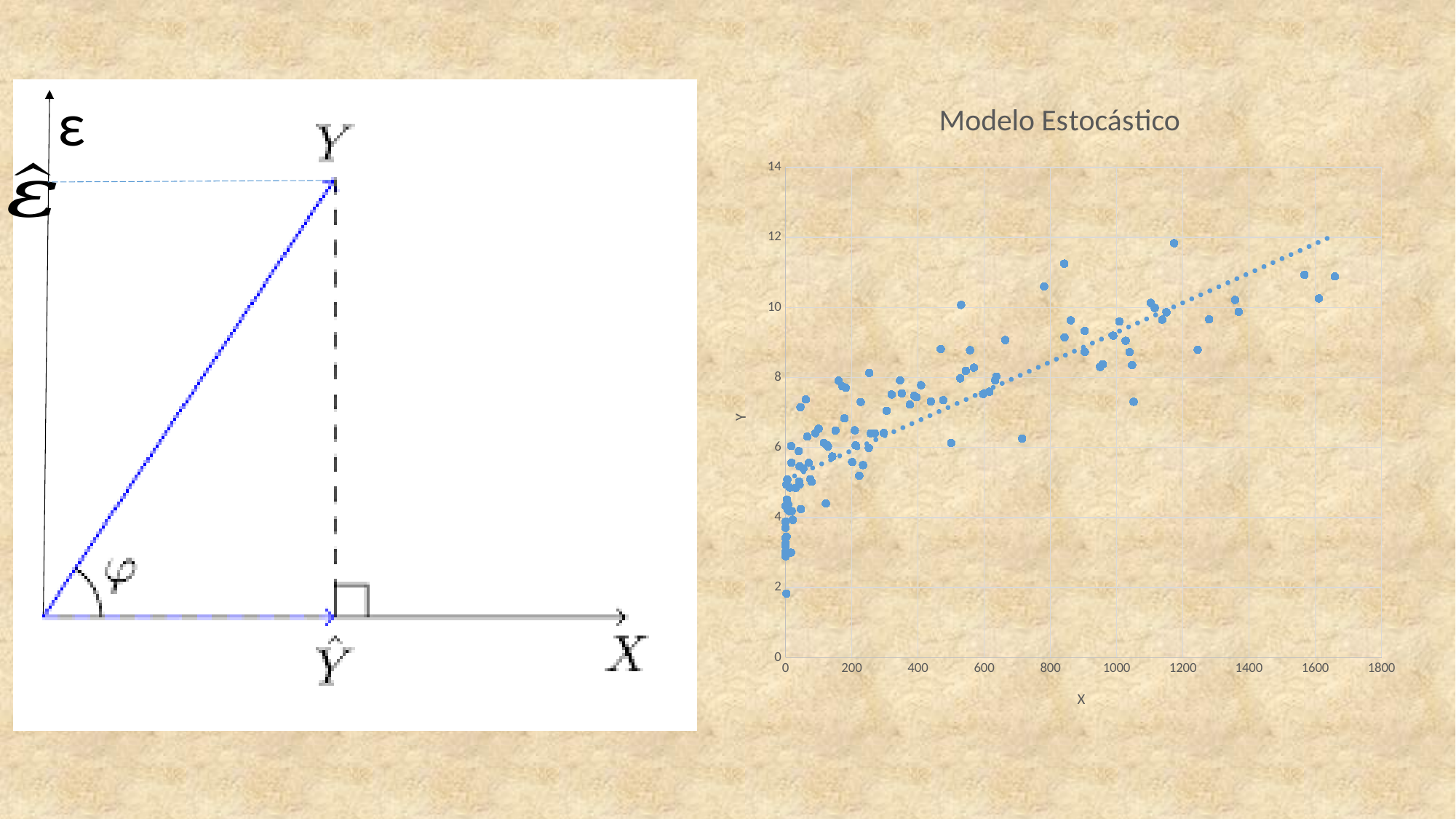
In the 'Modelo Estocástico' chart, what is the highest tick value shown on the vertical axis? 14 In the 'Modelo Estocástico' chart, what is the highest tick value shown on the horizontal axis? 1800 In the 'Modelo Estocástico' chart, do the Y values generally rise or fall as X increases? rise What kind of chart is the 'Modelo Estocástico' chart on the right of the slide? scatter chart In the 'Modelo Estocástico' chart, does the dotted trend line slope upward or downward from left to right? upward What is the title of the chart on the right of the slide? Modelo Estocástico In the 'Modelo Estocástico' chart, is the Y value of the point with the largest X value greater or less than 8? greater In the 'Modelo Estocástico' chart, is the Y value of the lowest plotted point greater or less than 4? less In the 'Modelo Estocástico' chart, is the Y value of the highest plotted point greater or less than 10? greater In the 'Modelo Estocástico' chart, what is the label of the horizontal axis? X